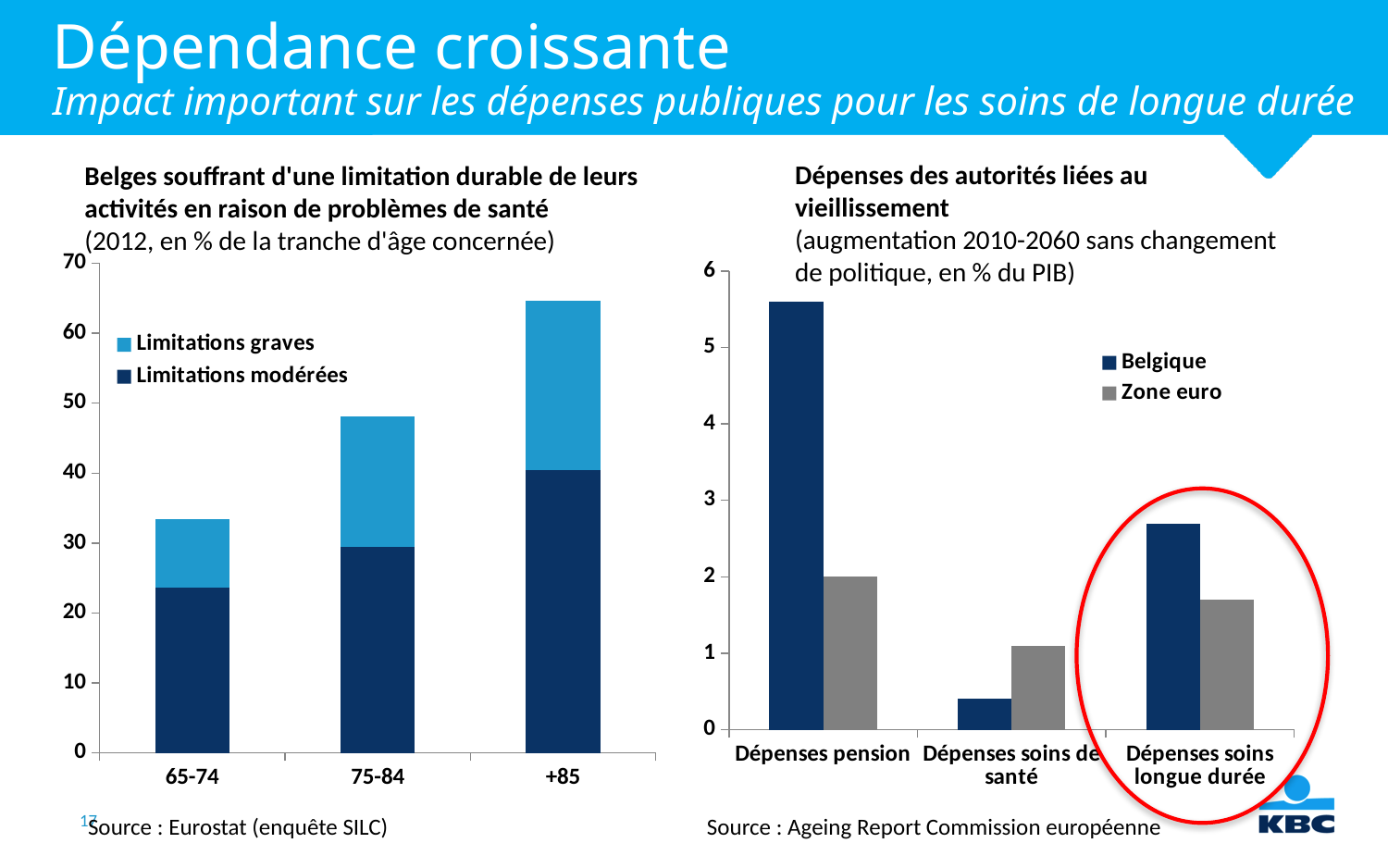
What kind of chart is the left chart, 'Belges souffrant d'une limitation durable de leurs activités en raison de problèmes de santé'? Stacked bar chart How many age groups are shown on the x axis of the left chart? 3 In the right chart, which category has the lowest value for Belgique? Dépenses soins de santé In the left chart, is the 'Limitations modérées' value for 65-74 greater or less than 30? less In the right chart, is the Belgique value for 'Dépenses pension' greater or less than 5? greater In the left chart, is the total stacked bar for 75-84 greater or less than 40? greater In the right chart, which category has the highest value for Belgique? Dépenses pension In the right chart, 'Dépenses des autorités liées au vieillissement', how many series does the legend list? 2 In the left chart, which age group has the tallest stacked bar? +85 In the right chart, for 'Dépenses soins longue durée', which is larger: Belgique or Zone euro? Belgique In the left chart, do the stacked bar totals rise or fall from 65-74 to +85? Rise How many series does the legend of the left chart list? 2